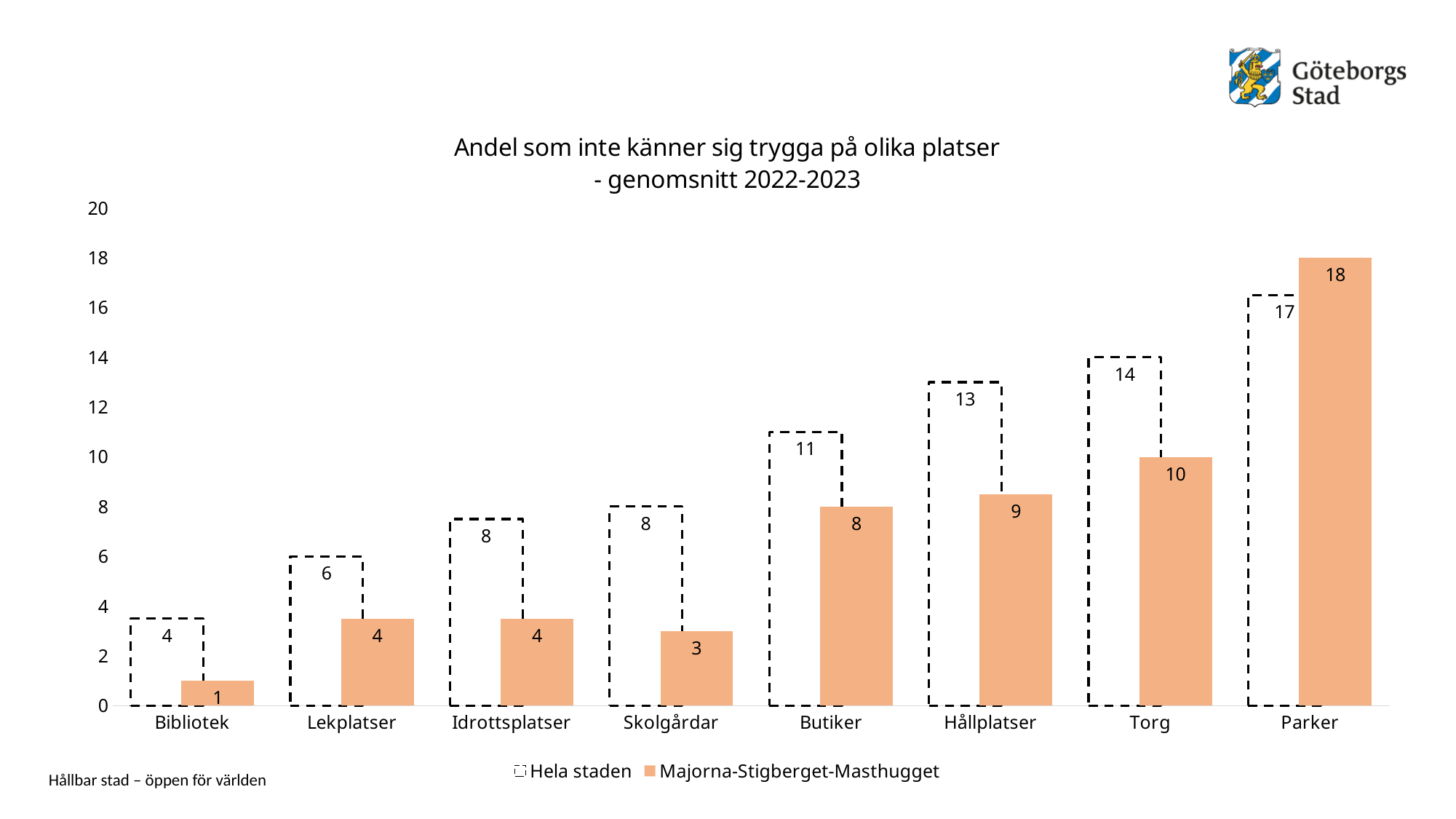
Is the value for Majorna-Stigberget-Masthugget at Hållplatser greater or less than 10? less Which category has the highest value for Hela staden? Parker Which category has the lowest value for Majorna-Stigberget-Masthugget? Bibliotek What kind of chart is shown? bar chart What is the value for Majorna-Stigberget-Masthugget at Parker? 18 What is the value for Majorna-Stigberget-Masthugget at Bibliotek? 1 Which is larger at Skolgårdar: Hela staden or Majorna-Stigberget-Masthugget? Hela staden How many series does the legend list? 2 What is the value for Hela staden at Butiker? 11 What is the difference between Hela staden and Majorna-Stigberget-Masthugget at Torg? 4 Do the values for Hela staden rise or fall from Bibliotek to Parker? rise How many categories are shown on the x axis? 8